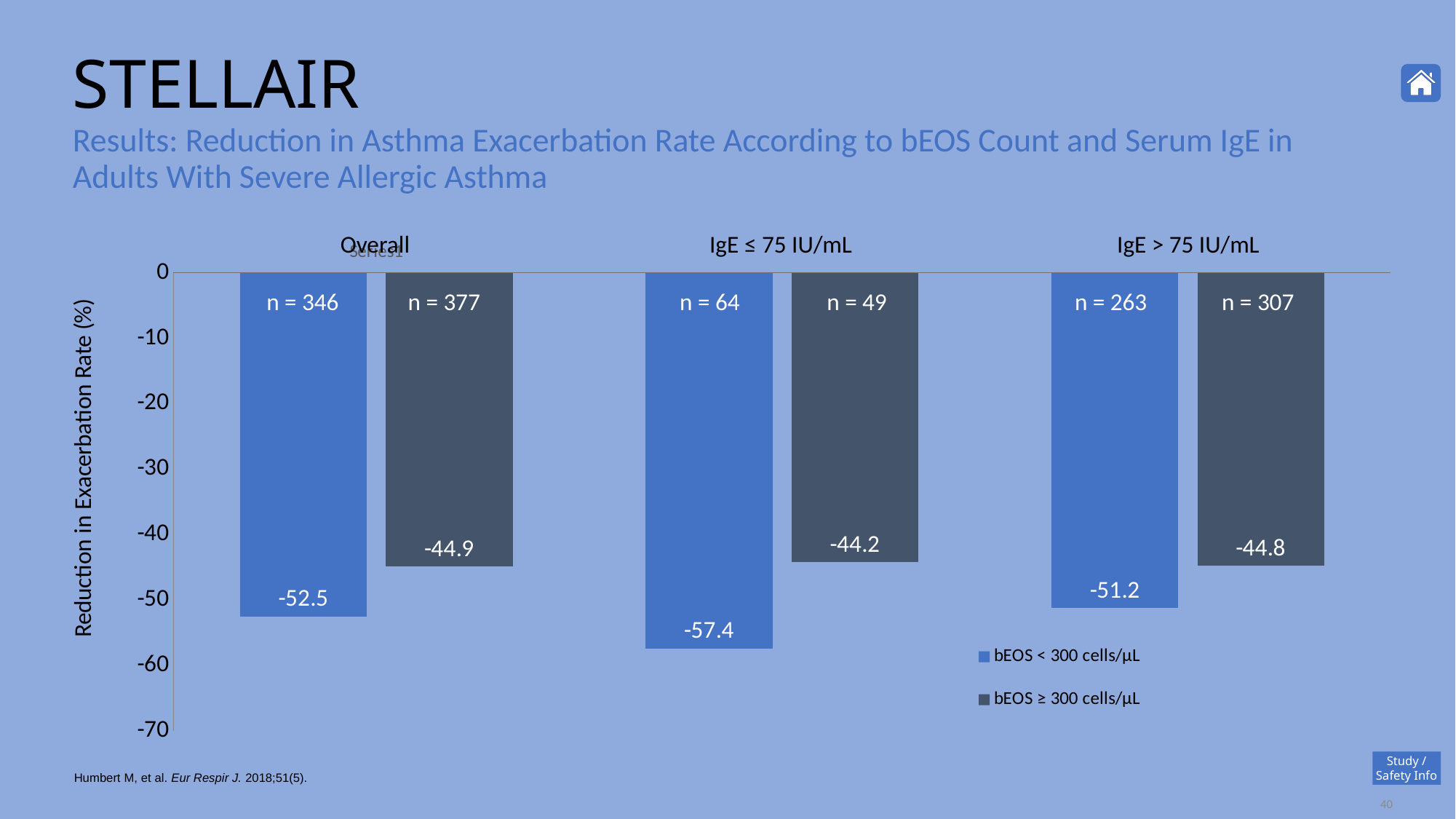
In the IgE > 75 IU/mL category, which group shows a larger reduction in exacerbation rate: bEOS < 300 cells/µL or bEOS ≥ 300 cells/µL? bEOS < 300 cells/µL What is the sample size (n) shown for the bEOS < 300 cells/µL bar in the IgE ≤ 75 IU/mL category? n = 64 What kind of chart is shown on the slide? Bar chart Which bar shows the largest reduction in exacerbation rate (most negative value)? bEOS < 300 cells/µL in IgE ≤ 75 IU/mL (-57.4) What is the reduction in exacerbation rate for the bEOS < 300 cells/µL group in the Overall category? -52.5 How many series does the legend list? 2 What is the reduction in exacerbation rate for the bEOS < 300 cells/µL group in the IgE > 75 IU/mL category? -51.2 What is the difference between the bEOS < 300 cells/µL and bEOS ≥ 300 cells/µL values in the IgE ≤ 75 IU/mL category? 13.2 How many categories are shown on the x axis of the chart? 3 What is the difference between the bEOS < 300 cells/µL and bEOS ≥ 300 cells/µL values in the Overall category? 7.6 What is the reduction in exacerbation rate for the bEOS ≥ 300 cells/µL group in the IgE ≤ 75 IU/mL category? -44.2 What is the sample size (n) shown for the bEOS ≥ 300 cells/µL bar in the Overall category? n = 377